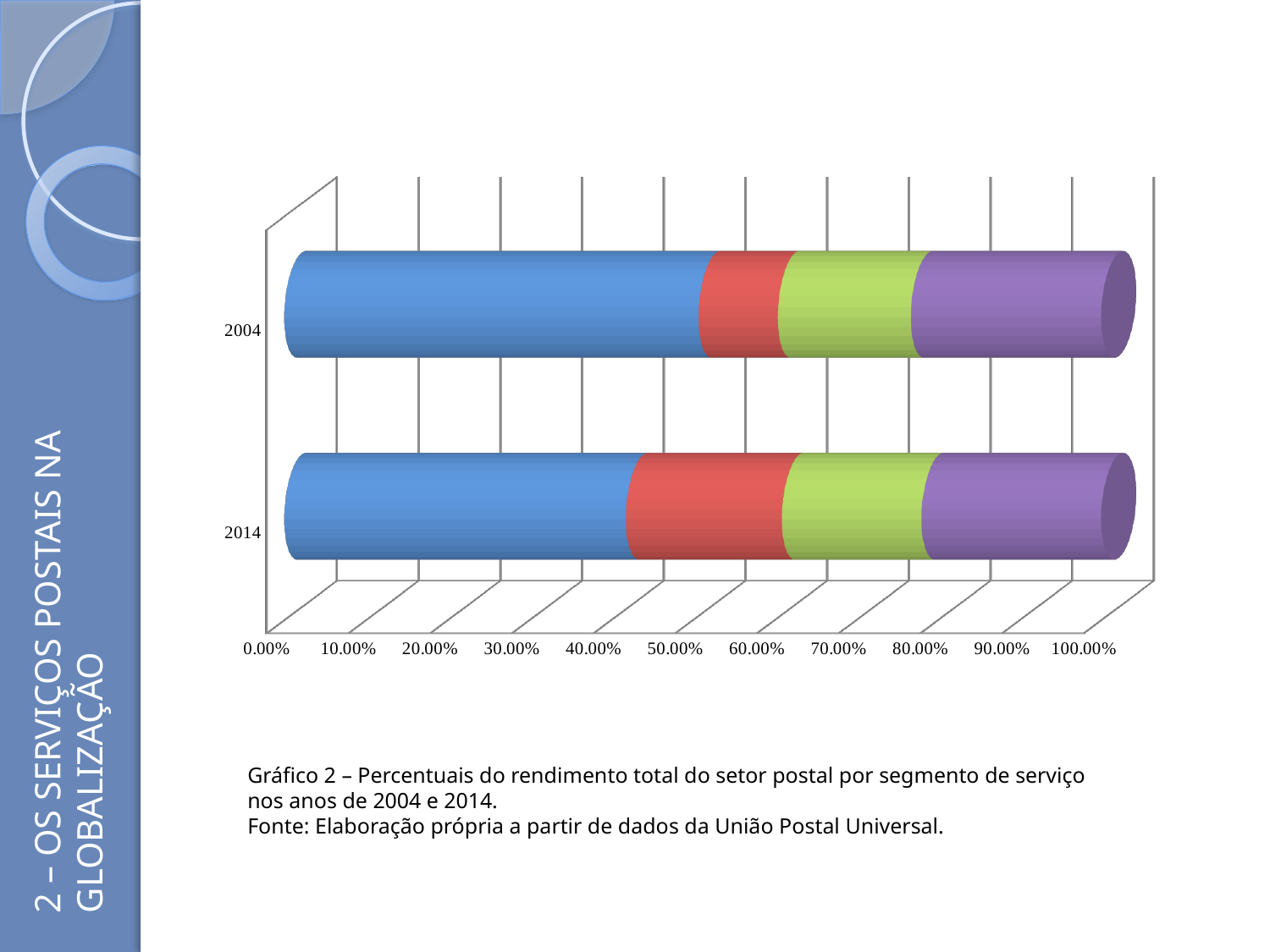
Which year has the larger red segment, 2004 or 2014? 2014 What kind of chart is shown on the slide? Stacked bar chart Is the blue segment for 2014 greater or less than 30.00%? greater How many coloured segments make up each stacked bar? 4 What is the highest value shown on the horizontal axis of the chart? 100.00% Is the red segment for 2004 greater or less than 20.00%? less How many years (categories) are plotted on the chart? 2 Which two years are shown on the vertical axis of the chart? 2004 and 2014 Does the blue segment rise or fall from 2004 to 2014? fall Is the red segment for 2014 greater or less than 10.00%? greater Which year has the larger blue segment, 2004 or 2014? 2004